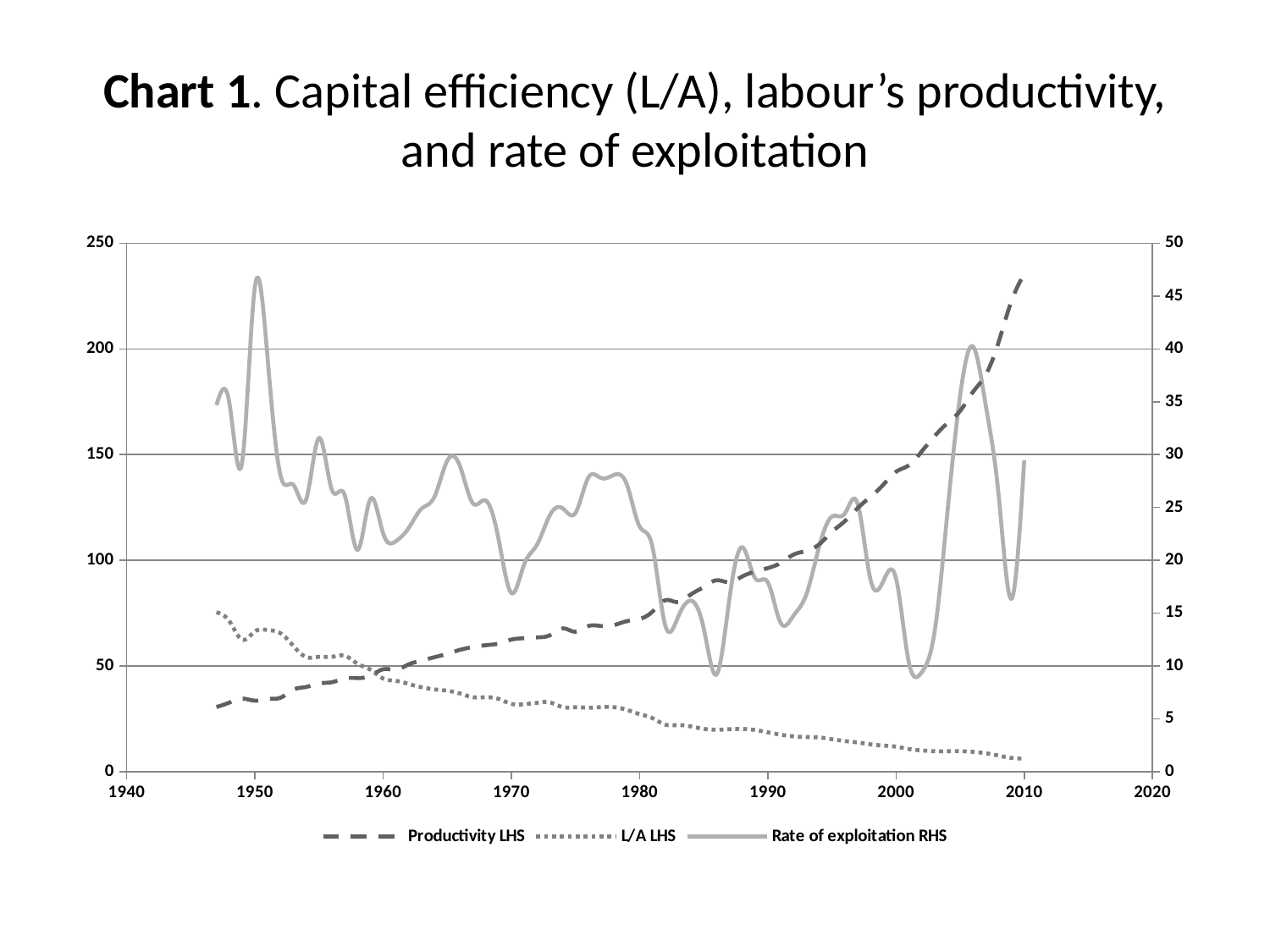
What kind of chart is shown on the slide? line chart Is the value for Productivity LHS in 1950 greater or less than 50? less Is the value for Rate of exploitation RHS at its peak around 1950 greater or less than 40 on the right-hand axis? greater Is the value for Rate of exploitation RHS in 1986 greater or less than 15 on the right-hand axis? less How many series does the legend list? 3 Does the Productivity LHS series generally rise or fall from 1947 to 2010? rise Which series are listed in the legend? Productivity LHS, L/A LHS, Rate of exploitation RHS Does the L/A LHS series generally rise or fall from 1947 to 2010? fall In 1950, which is larger: Productivity LHS or L/A LHS? L/A LHS In 2010, which is larger: Productivity LHS or L/A LHS? Productivity LHS